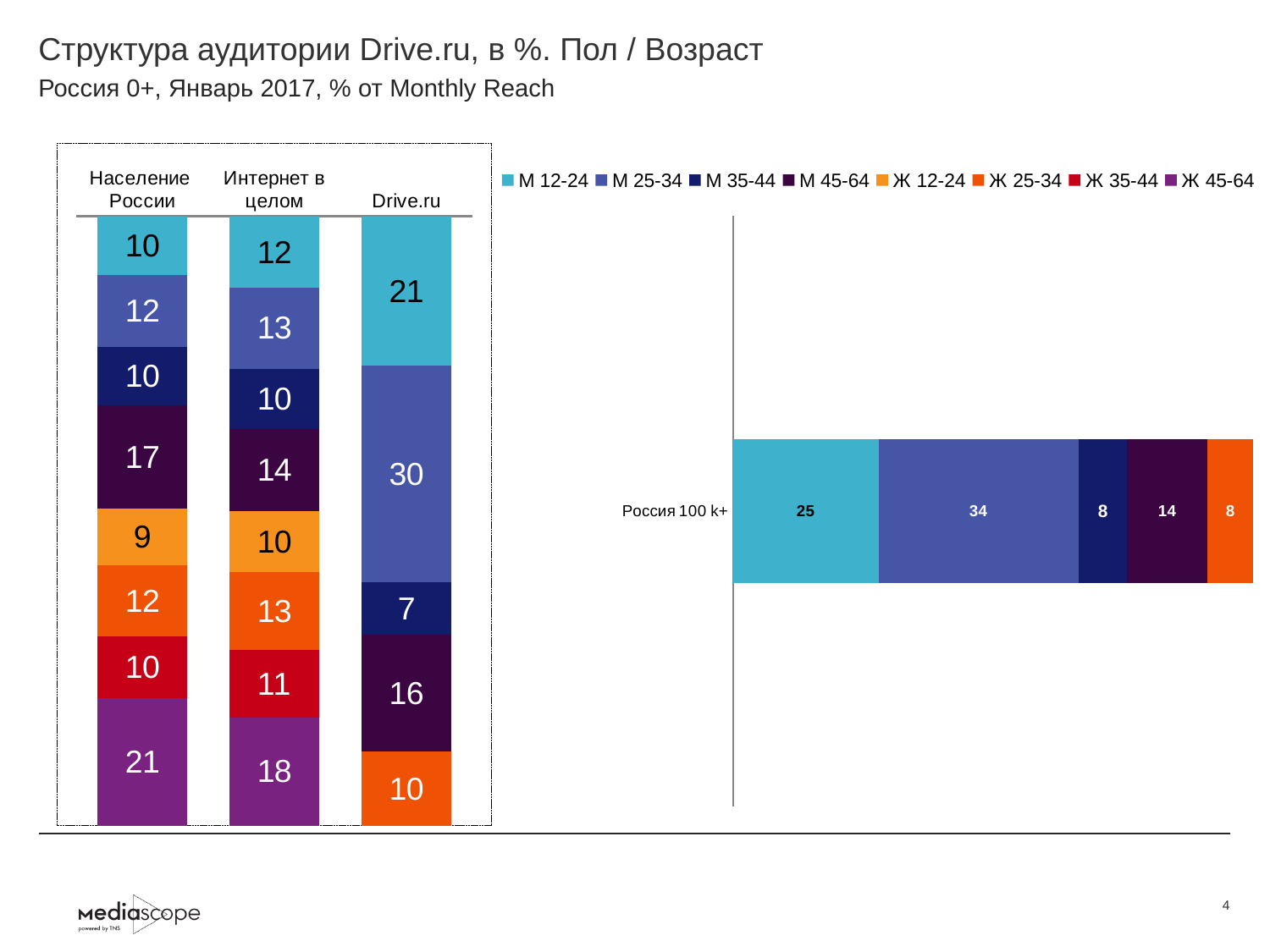
In the left chart, what is the value for Ж 45-64 in the Население России bar? 21 In the left chart, what is the value for М 25-34 in the Drive.ru bar? 30 In the right chart (Россия 100 k+), what is the value for М 25-34? 34 In the left chart, what is the value for М 45-64 in the Интернет в целом bar? 14 In the left chart, which segment of the Drive.ru bar has the largest value? М 25-34 In the left chart, which segment of the Drive.ru bar has the smallest value? М 35-44 In the left chart, what is the difference between the М 12-24 value for Drive.ru and the М 12-24 value for Население России? 11 In the right chart (Россия 100 k+), what is the value for М 45-64? 14 How many series does the legend list? 8 In the right chart, what is the total of the Россия 100 k+ bar? 89 In the left chart, which is larger: the М 45-64 value for Население России or for Интернет в целом? Население России What kind of chart is the right chart (Россия 100 k+)? Stacked bar chart